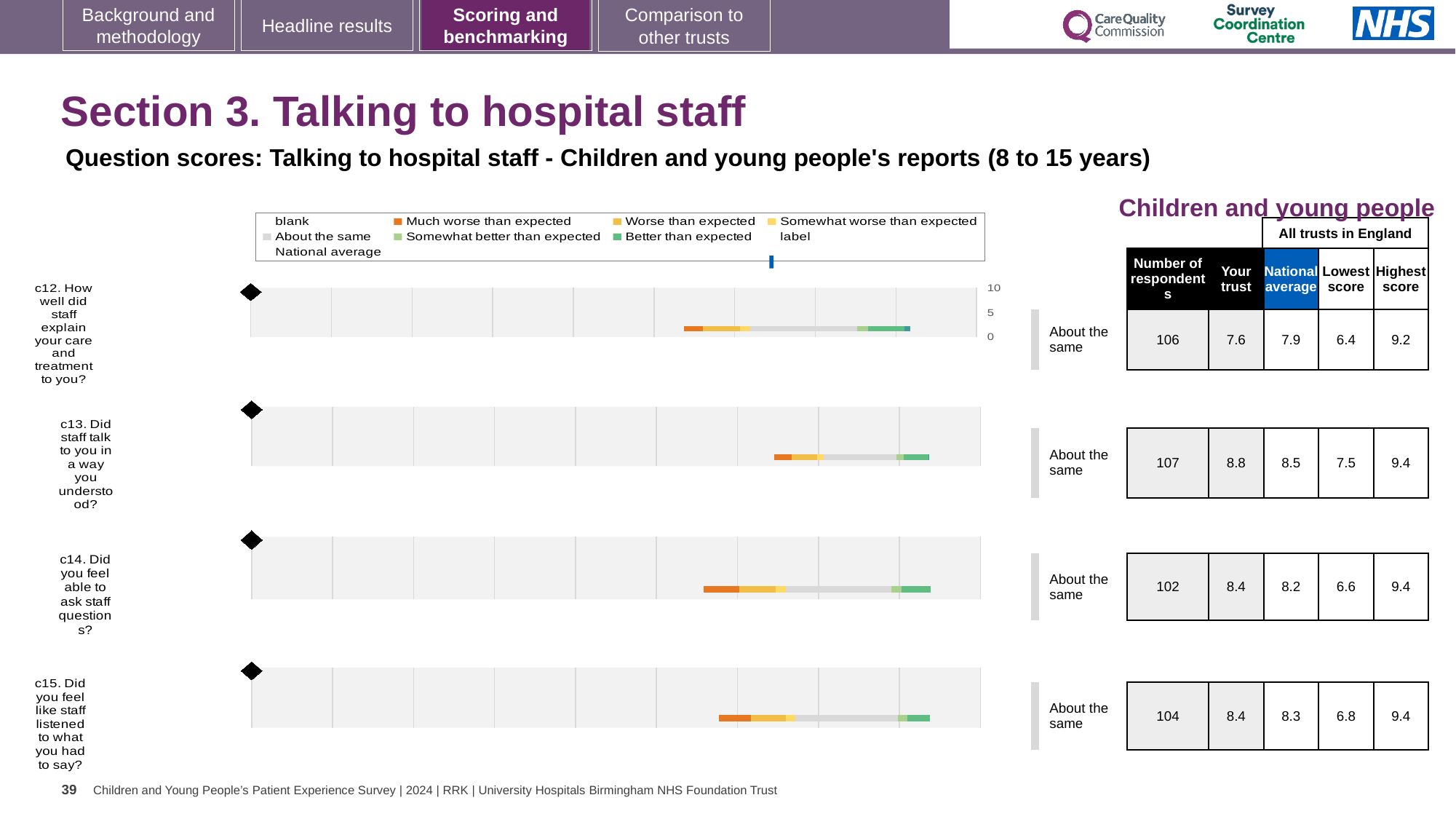
What benchmark category is shown next to the chart for c14? About the same Which question has the lowest 'Lowest score' among all trusts in England? c12 How many question charts are shown on this slide? 4 What is the 'Your trust' score for c12 (How well did staff explain your care and treatment to you?)? 7.6 How many respondents answered c14 (Did you feel able to ask staff questions?)? 102 What kind of chart is used to show each question's score? Bar chart For c13, how much higher is the 'Your trust' score than the national average? 0.3 Which question has the highest 'Your trust' score on this slide? c13 What is the highest score among all trusts in England for c15 (Did you feel like staff listened to what you had to say?)? 9.4 For c12, which is larger: the 'Your trust' score or the national average? National average What is the national average score for c13 (Did staff talk to you in a way you understood?)? 8.5 For c14, what is the difference between the highest score and the lowest score among all trusts in England? 2.8